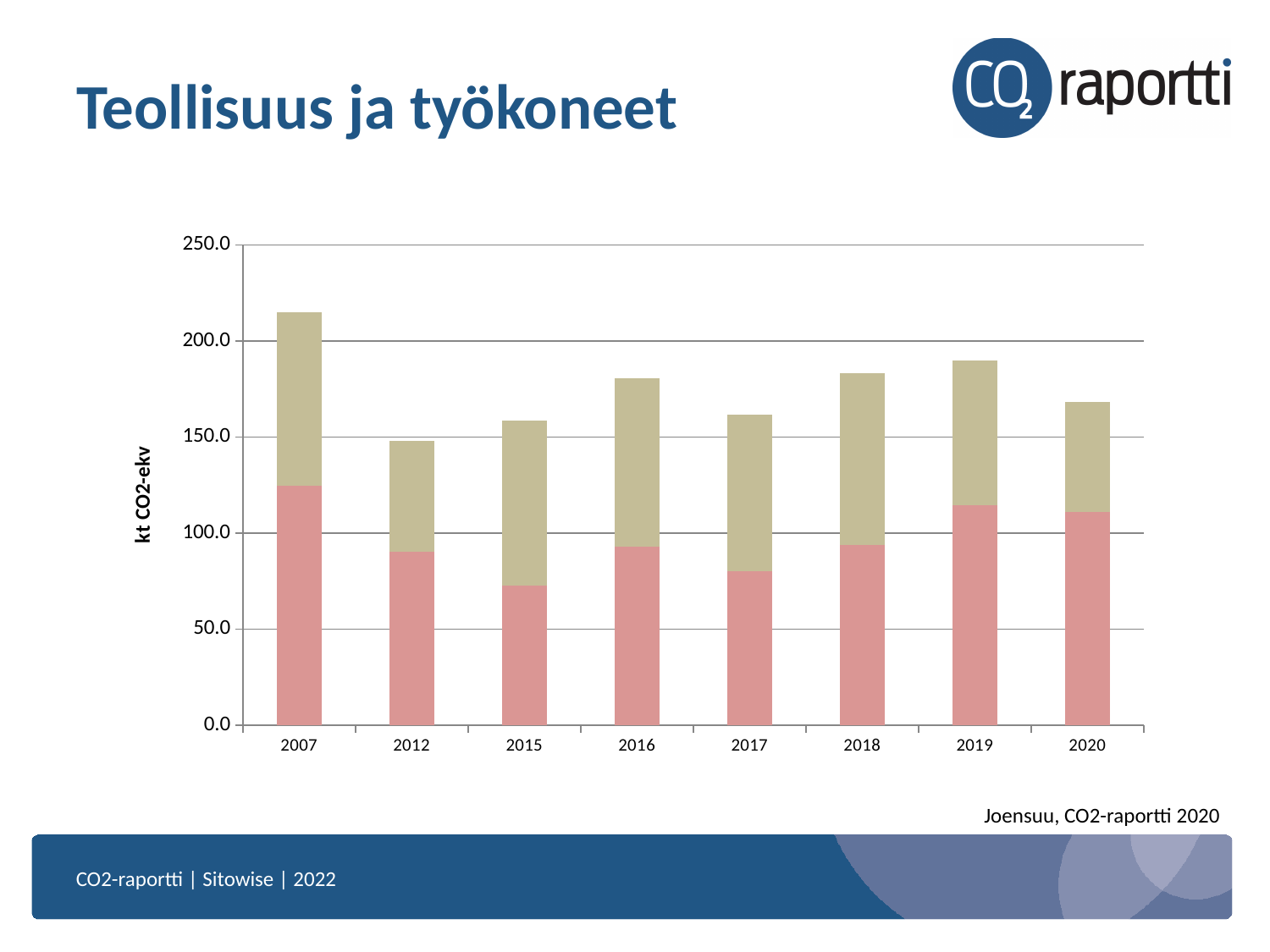
Is the total value for 2019 greater or less than 200.0? less Is the pink (bottom) segment for 2015 greater or less than 100.0? less How many years are shown on the x axis of the chart? 8 Is the total value for 2007 greater or less than 200.0? greater Which year has the larger total bar, 2018 or 2017? 2018 What kind of chart is shown on the slide? Stacked bar chart Which year has the lowest total bar in the chart? 2012 Which year has the highest total bar in the chart? 2007 What is the label on the vertical axis of the chart? kt CO2-ekv Do the total values rise or fall from 2007 to 2012? fall